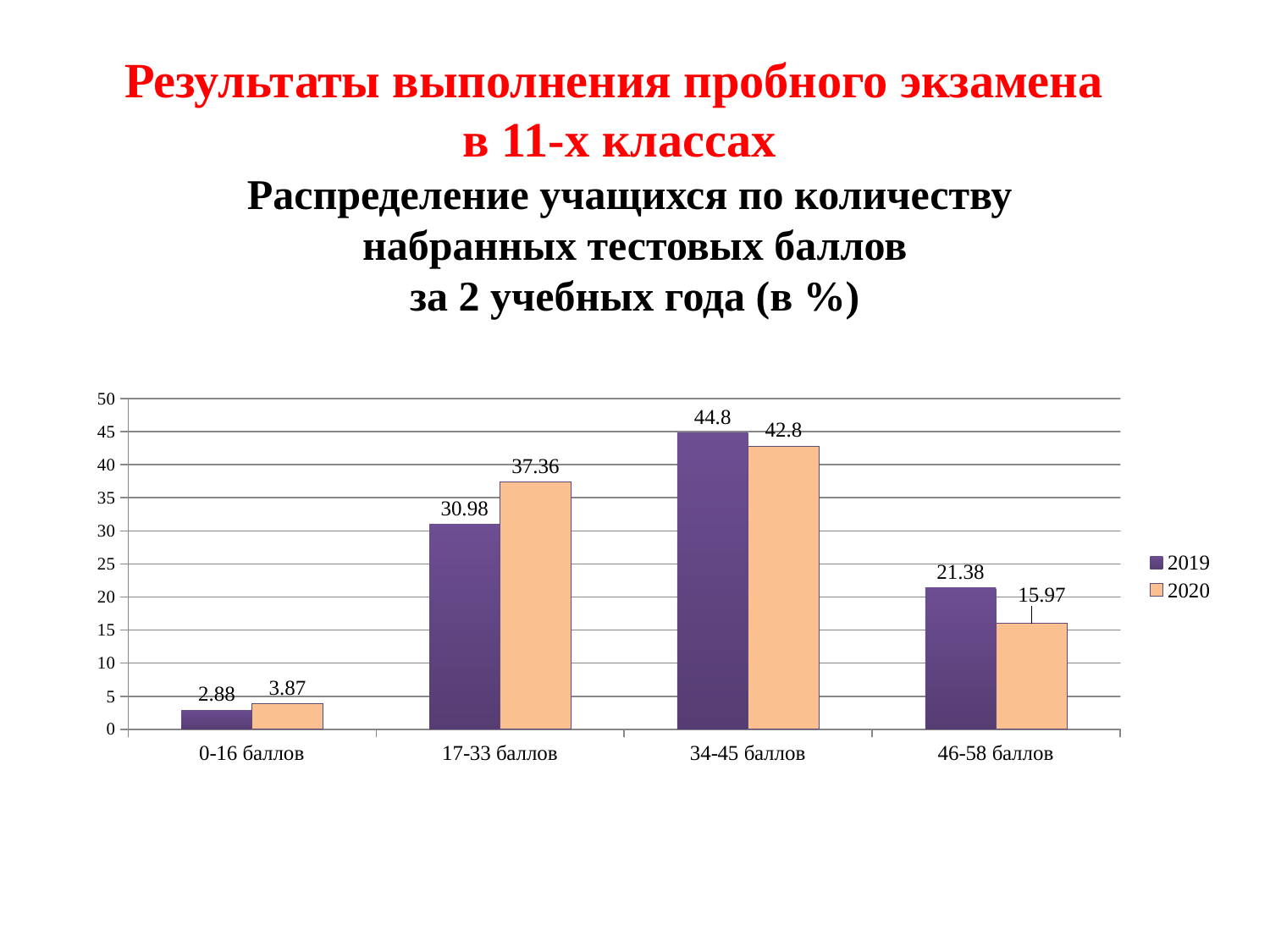
How many categories are shown on the x axis? 4 What is the value for 2019 in the 17-33 баллов category? 30.98 What kind of chart is shown on the slide? bar chart What is the value for 2020 in the 0-16 баллов category? 3.87 In the 46-58 баллов category, which series has the larger value, 2019 or 2020? 2019 What is the difference between the 2019 and 2020 values in the 34-45 баллов category? 2 Which category has the lowest value for 2020? 0-16 баллов What is the difference between the 2020 and 2019 values in the 17-33 баллов category? 6.38 Which category has the highest value for 2019? 34-45 баллов What is the value for 2020 in the 46-58 баллов category? 15.97 Is the value for 2019 in the 34-45 баллов category greater or less than 40? greater How many series does the legend list? 2